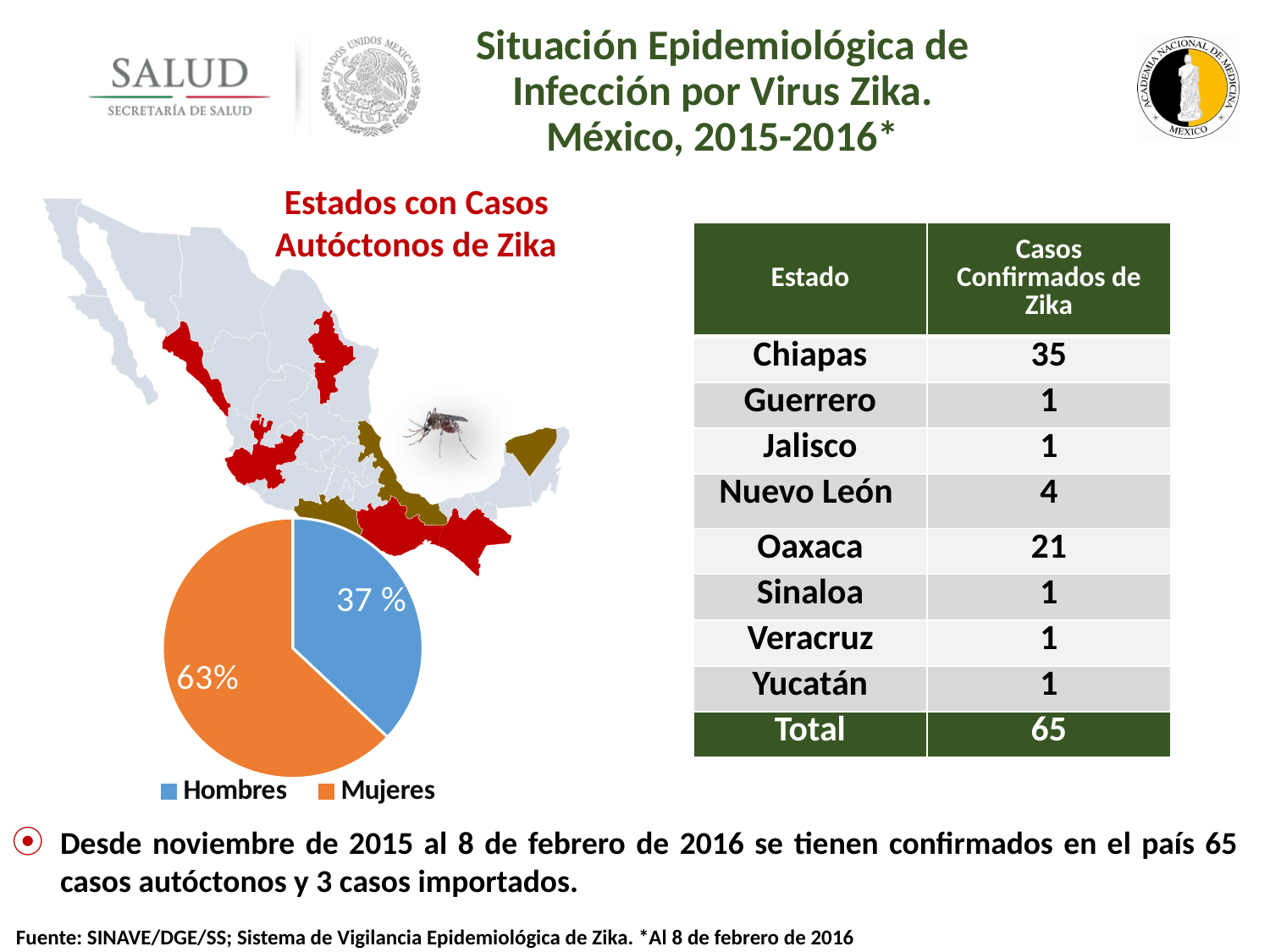
What colour is the Mujeres slice in the pie chart? orange Which slice of the pie chart is the largest? Mujeres Is the share for Mujeres in the pie chart greater or less than 50%? greater Which slice of the pie chart is the smallest? Hombres In the pie chart, what share is shown for Hombres? 37 % What colour is the Hombres slice in the pie chart? blue How many slices does the pie chart have? 2 In the pie chart, which is larger, the share for Hombres or the share for Mujeres? Mujeres In the pie chart, what share is shown for Mujeres? 63% How many entries does the pie chart legend list? 2 What kind of chart is shown on the slide? pie chart What is the difference in percentage points between the Mujeres and Hombres slices of the pie chart? 26